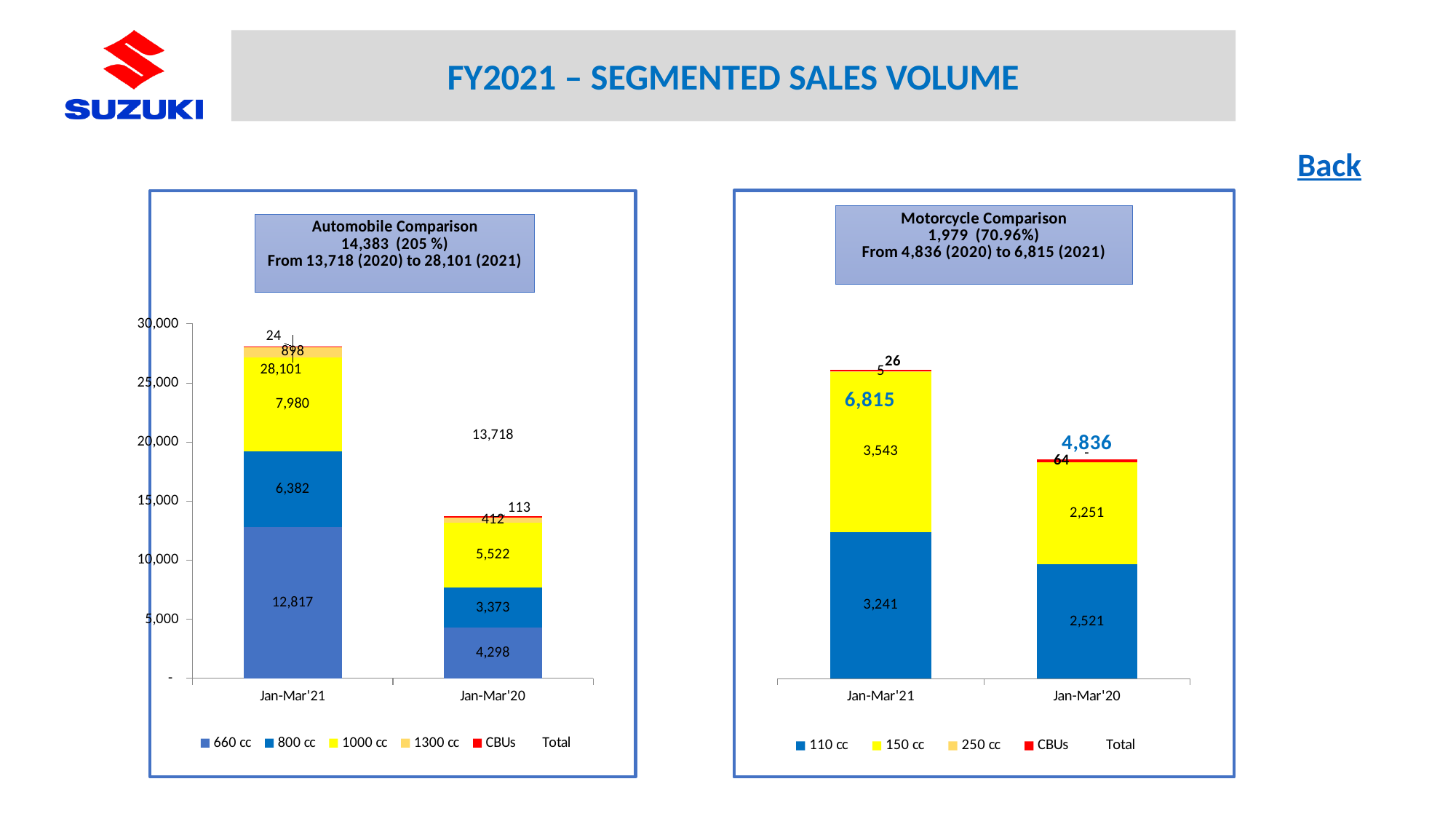
In the Automobile Comparison chart, what is the value for 660 cc in Jan-Mar'21? 12,817 What kind of chart is the Motorcycle Comparison chart? Stacked bar chart In the Motorcycle Comparison chart, what is the value for 110 cc in Jan-Mar'20? 2,521 In the Automobile Comparison chart, what is the total for Jan-Mar'21? 28,101 How many series does the legend of the Automobile Comparison chart list? 6 In the Automobile Comparison chart, what is the value for 1000 cc in Jan-Mar'20? 5,522 In the Automobile Comparison chart, which is larger in Jan-Mar'21: 800 cc or 1000 cc? 1000 cc How many categories are shown on the x axis of the Motorcycle Comparison chart? 2 In the Motorcycle Comparison chart, what is the difference between the 150 cc values for Jan-Mar'21 and Jan-Mar'20? 1,292 In the Motorcycle Comparison chart, what is the total for Jan-Mar'20? 4,836 In the Motorcycle Comparison chart, what is the value for 150 cc in Jan-Mar'21? 3,543 In the Automobile Comparison chart, what is the difference between the 800 cc values for Jan-Mar'21 and Jan-Mar'20? 3,009